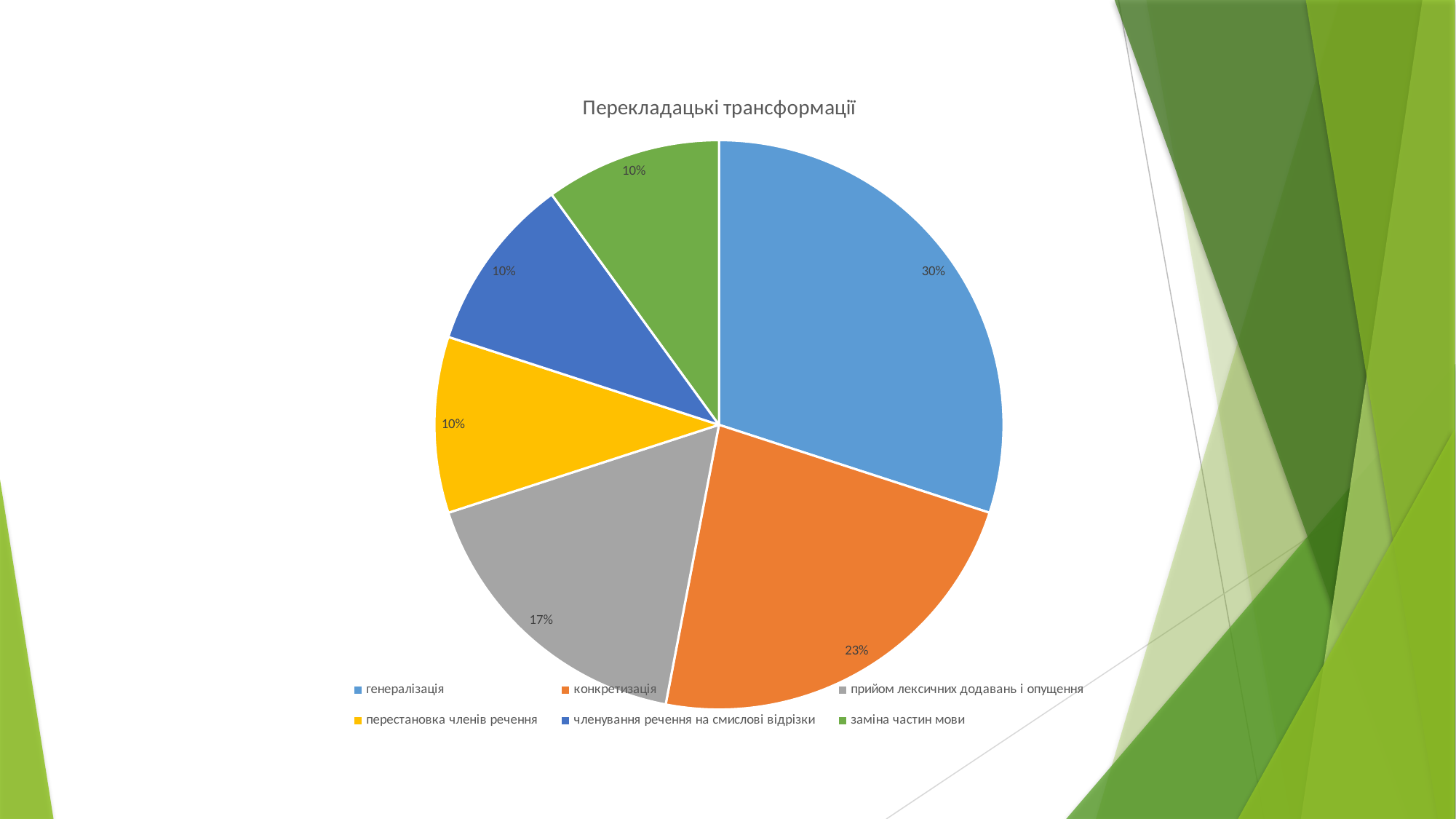
Which colour represents членування речення на смислові відрізки in the legend? dark blue What share of the pie does генералізація have? 30% What is the difference between the shares of генералізація and конкретизація? 7% What share of the pie does прийом лексичних додавань і опущення have? 17% Which is larger, the share of конкретизація or the share of прийом лексичних додавань і опущення? конкретизація How many categories does the pie chart show? 6 What share of the pie does заміна частин мови have? 10% What is the difference between the shares of прийом лексичних додавань і опущення and перестановка членів речення? 7% What is the title of the chart? Перекладацькі трансформації Which category has the largest slice of the pie? генералізація What share of the pie does конкретизація have? 23% What kind of chart is shown on the slide? pie chart